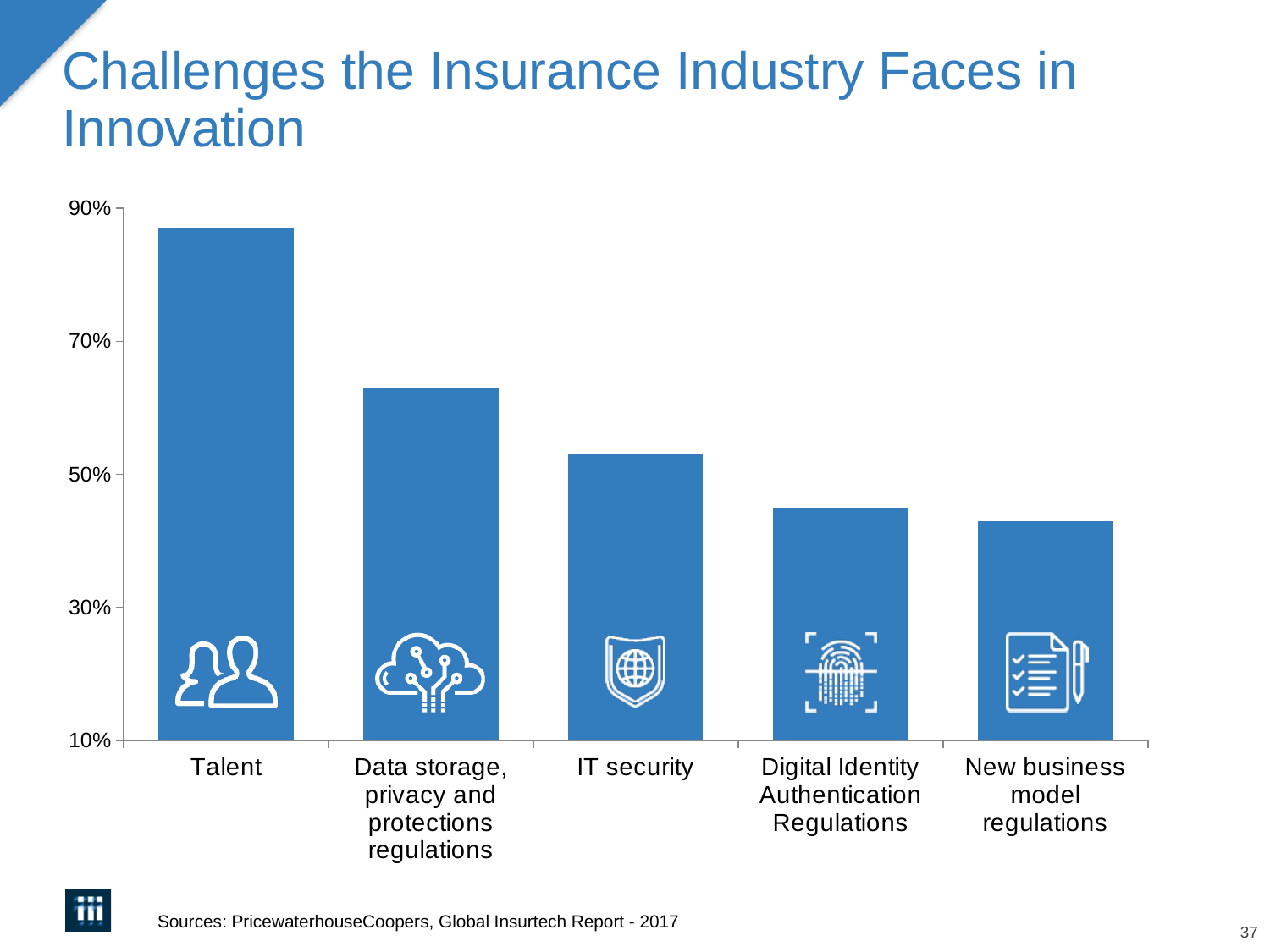
Is the value for Talent greater or less than 70%? greater Is the value for Digital Identity Authentication Regulations greater or less than 50%? less Do the values rise or fall from left to right across the categories? fall Is the value for Data storage, privacy and protections regulations greater or less than 50%? greater What kind of chart is shown on the slide? bar chart What is the title of the chart on the slide? Challenges the Insurance Industry Faces in Innovation How many categories are shown on the chart? 5 Which category has the highest value? Talent Which is larger, the value for Data storage, privacy and protections regulations or the value for New business model regulations? Data storage, privacy and protections regulations Which is larger, the value for Talent or the value for IT security? Talent